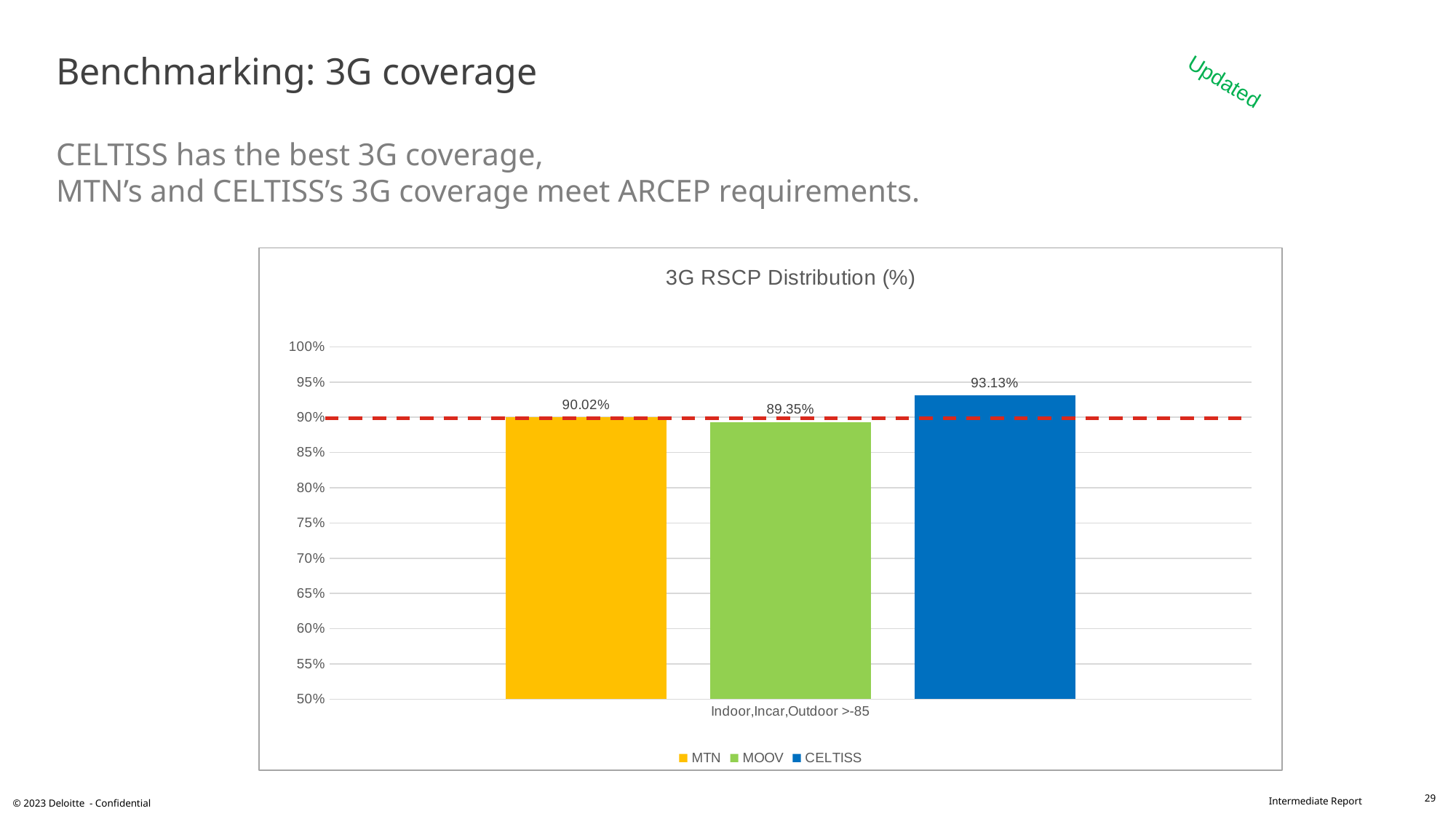
What is the title of the chart on the slide? 3G RSCP Distribution (%) What kind of chart is the 3G RSCP Distribution chart? bar chart How many series does the legend of the 3G RSCP Distribution chart list? 3 Which operator has the lowest 3G RSCP Distribution value? MOOV What is the difference between the CELTISS and MTN values in the 3G RSCP Distribution chart? 3.11% What is the difference between the MTN and MOOV values in the 3G RSCP Distribution chart? 0.67% Which operator has the highest 3G RSCP Distribution value? CELTISS What is the value for CELTISS in the 3G RSCP Distribution chart? 93.13% Which is larger in the 3G RSCP Distribution chart, the value for MTN or the value for MOOV? MTN Is the value for MOOV greater or less than 90%? less What is the value for MOOV in the 3G RSCP Distribution chart? 89.35% What is the value for MTN in the 3G RSCP Distribution chart? 90.02%